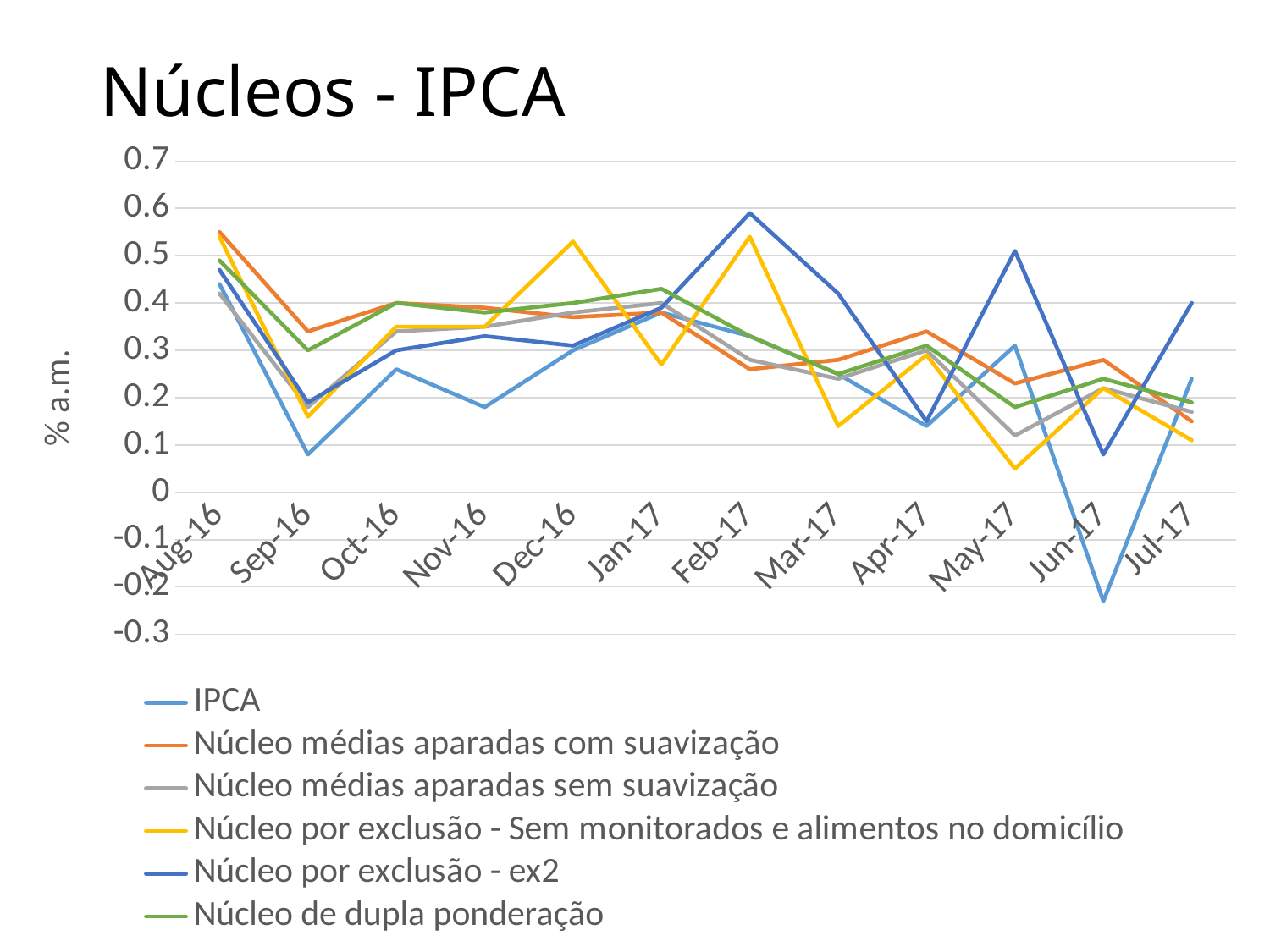
Is the value of Núcleo de dupla ponderação in Aug-16 greater or less than 0.4? greater Is the value of IPCA in Jun-17 greater or less than 0? less What kind of chart is shown on the slide? line chart What is the label on the vertical axis? % a.m. How many months are plotted along the x axis? 12 How many series does the legend list? 6 In Jun-17, which is larger: IPCA or Núcleo por exclusão - ex2? Núcleo por exclusão - ex2 Which series has the lowest value in Jun-17? IPCA What is the title of the chart? Núcleos - IPCA Which series has the lowest value in Sep-16? IPCA Is the value of Núcleo por exclusão - ex2 in Feb-17 greater or less than 0.5? greater Which series has the highest value in May-17? Núcleo por exclusão - ex2